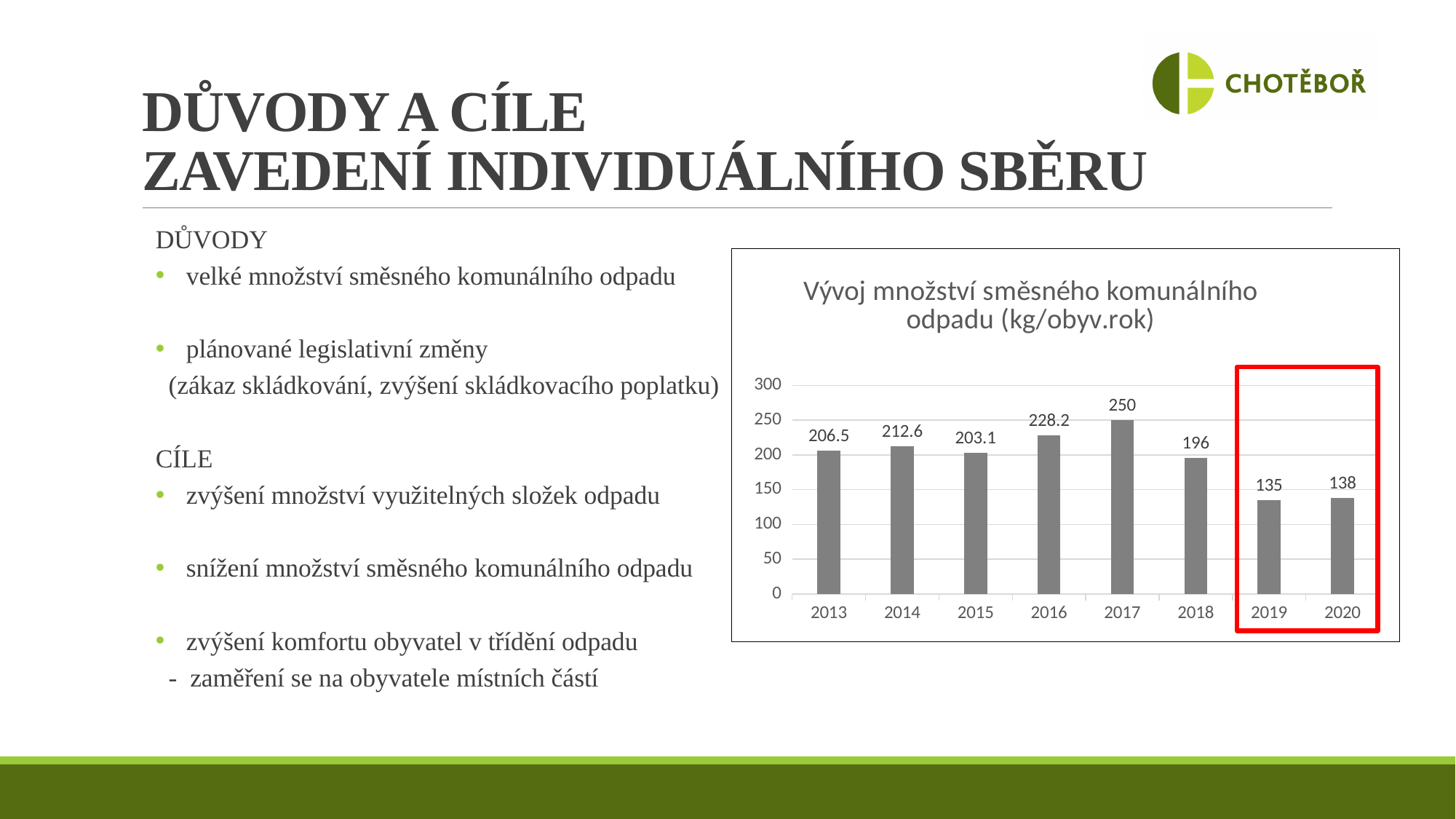
Is the value for 2018 greater or less than 150? greater What is the title of the chart? Vývoj množství směsného komunálního odpadu (kg/obyv.rok) What is the value for 2019? 135 How many years are shown on the x axis? 8 Which is larger, the value for 2014 or the value for 2015? 2014 What kind of chart is shown on the slide? bar chart What is the value for 2013? 206.5 Which year has the lowest value? 2019 What is the difference between the values for 2017 and 2018? 54 What is the difference between the values for 2016 and 2015? 25.1 What is the value for 2017? 250 Which year has the highest value? 2017